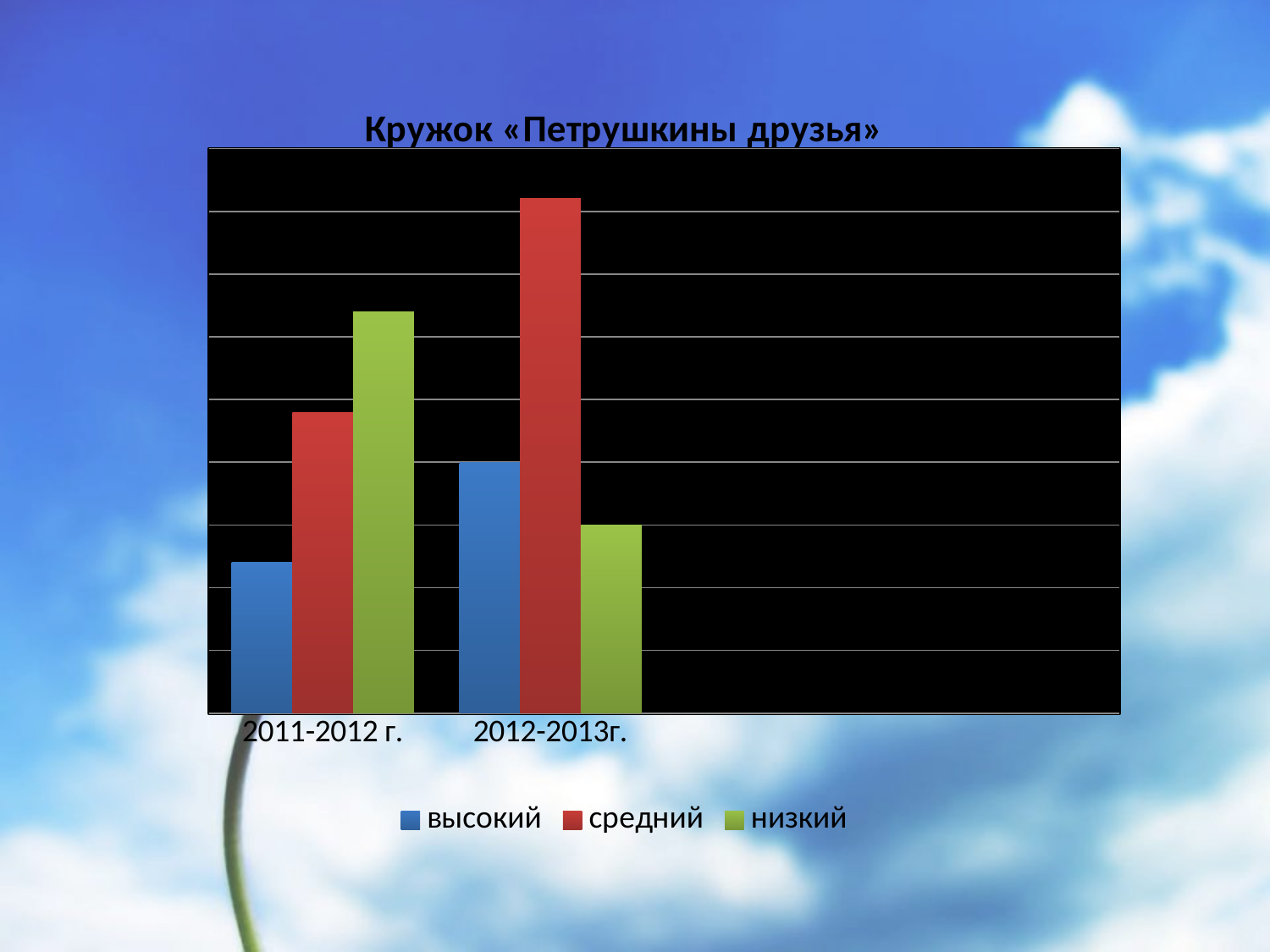
Which series has the highest bar for 2011-2012 г.? низкий Which series has the lowest bar for 2011-2012 г.? высокий Which is larger: средний for 2011-2012 г. or высокий for 2012-2013г.? средний for 2011-2012 г. Which series has the lowest bar for 2012-2013г.? низкий How many series does the legend list? 3 Does the value for высокий rise or fall from 2011-2012 г. to 2012-2013г.? rise How many categories are shown on the x axis? 2 Which colour represents the series средний in the legend? red Does the value for низкий rise or fall from 2011-2012 г. to 2012-2013г.? fall What kind of chart is shown on the slide? bar chart Which series has the highest bar for 2012-2013г.? средний What is the title of the chart? Кружок «Петрушкины друзья»